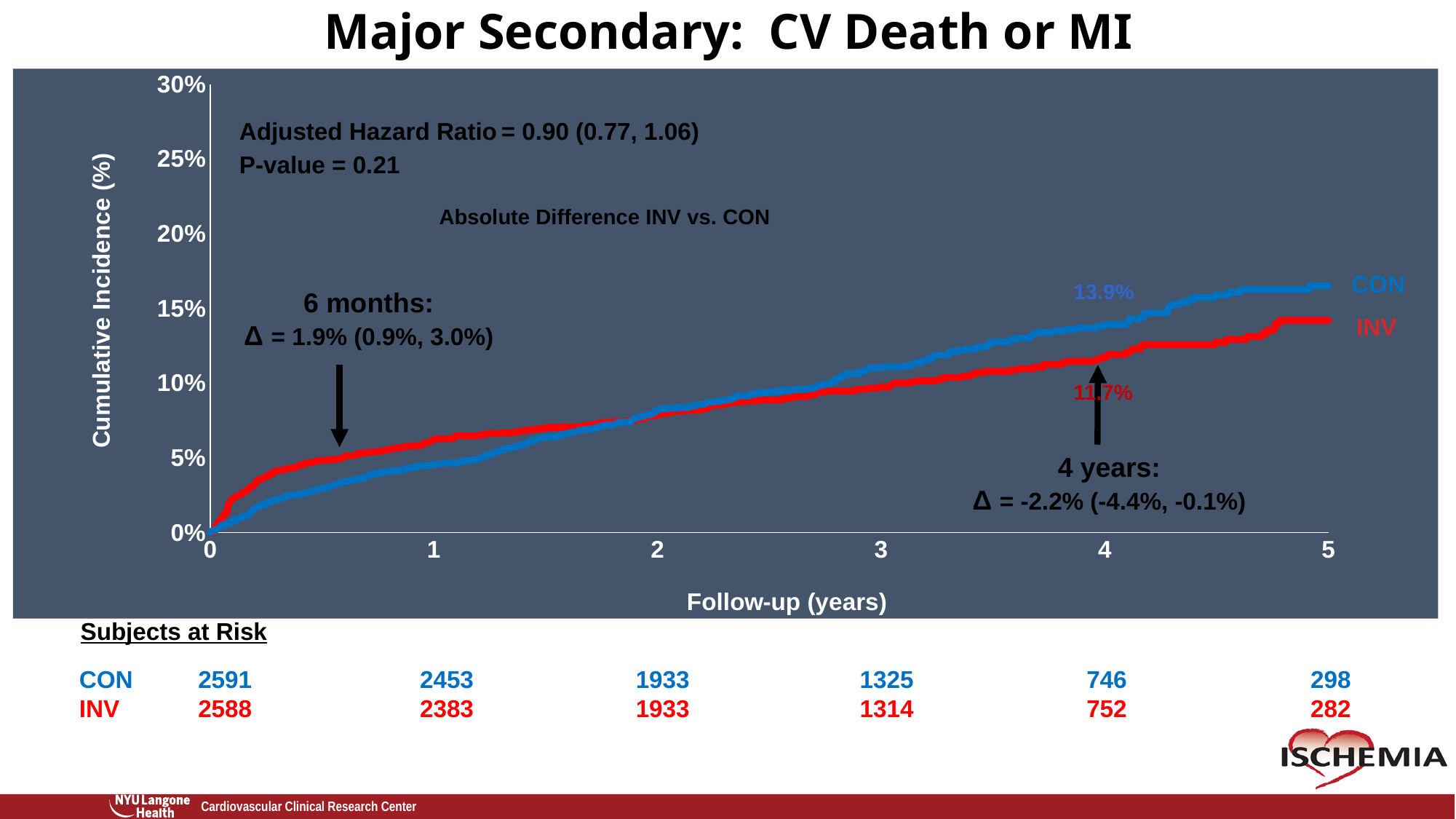
What is the label of the y-axis? Cumulative Incidence (%) Is the cumulative incidence for CON at 5 years greater or less than 15%? greater Do the cumulative incidence curves rise or fall as follow-up years increase? rise What is the adjusted hazard ratio shown on the chart? 0.90 (0.77, 1.06) At 6 months, which group has the higher cumulative incidence, CON or INV? INV What kind of chart is shown on the slide? line chart What is the cumulative incidence for INV at 4 years? 11.7% How many series are plotted on the chart? 2 By how many percentage points does the CON cumulative incidence exceed INV at 4 years? 2.2% What is the cumulative incidence for CON at 4 years? 13.9% At 4 years, which group has the higher cumulative incidence, CON or INV? CON Is the cumulative incidence for INV at 5 years greater or less than 15%? less